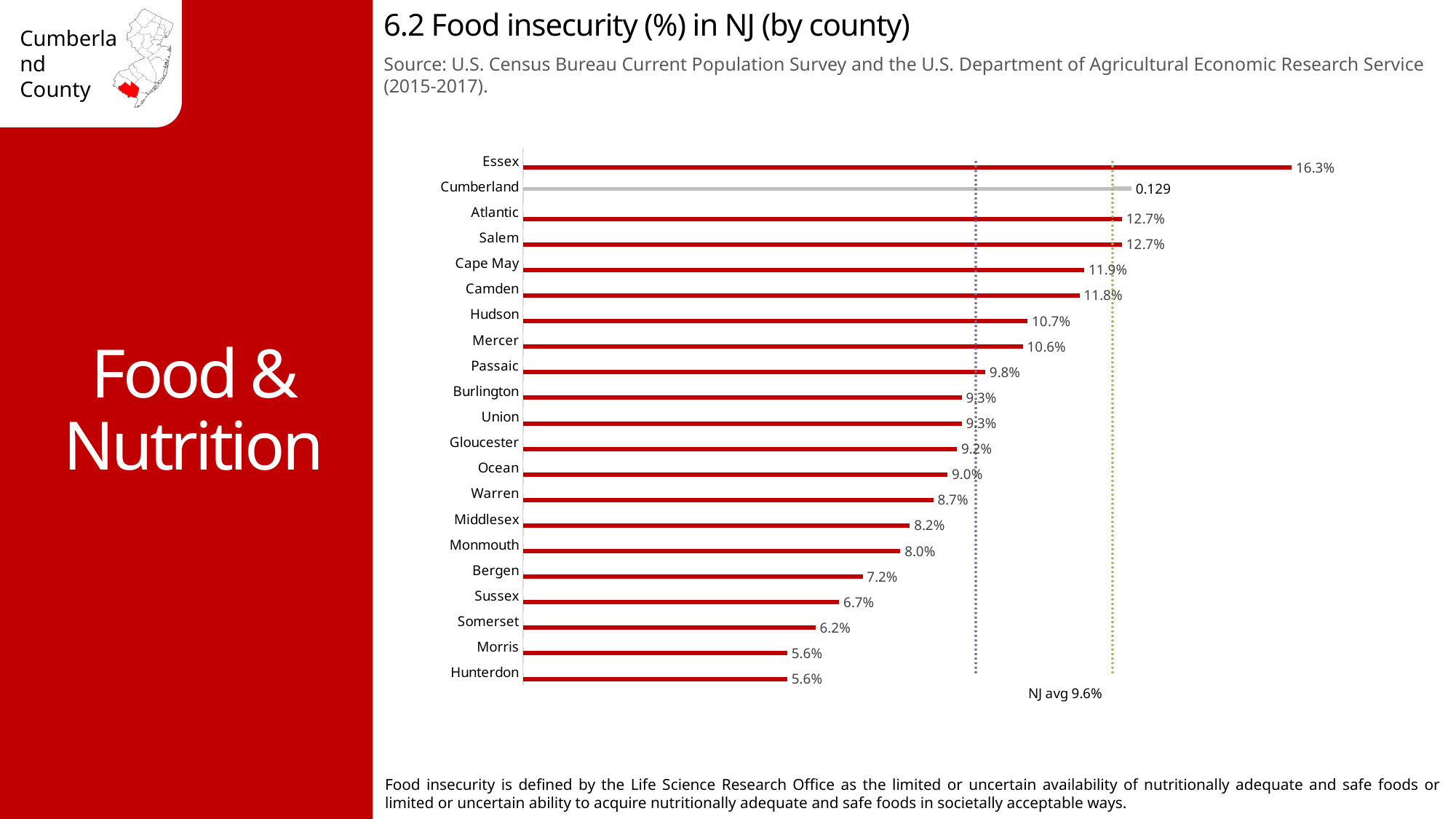
Which county has a higher food insecurity value, Sussex or Middlesex? Middlesex What is the difference between the food insecurity values for Cape May and Somerset counties? 5.7% What is the food insecurity value for Bergen county? 7.2% What is the food insecurity value for Camden county? 11.8% What NJ average value is noted on the chart? 9.6% What is the difference between the food insecurity values for Essex and Atlantic counties? 3.6% What kind of chart is used to show food insecurity by county? Bar chart What value is labeled on the Cumberland bar? 0.129 How many counties are shown on the chart? 21 What is the food insecurity value shown for Essex county? 16.3% Which county has the highest food insecurity value on the chart? Essex Which county has a higher food insecurity value, Passaic or Warren? Passaic